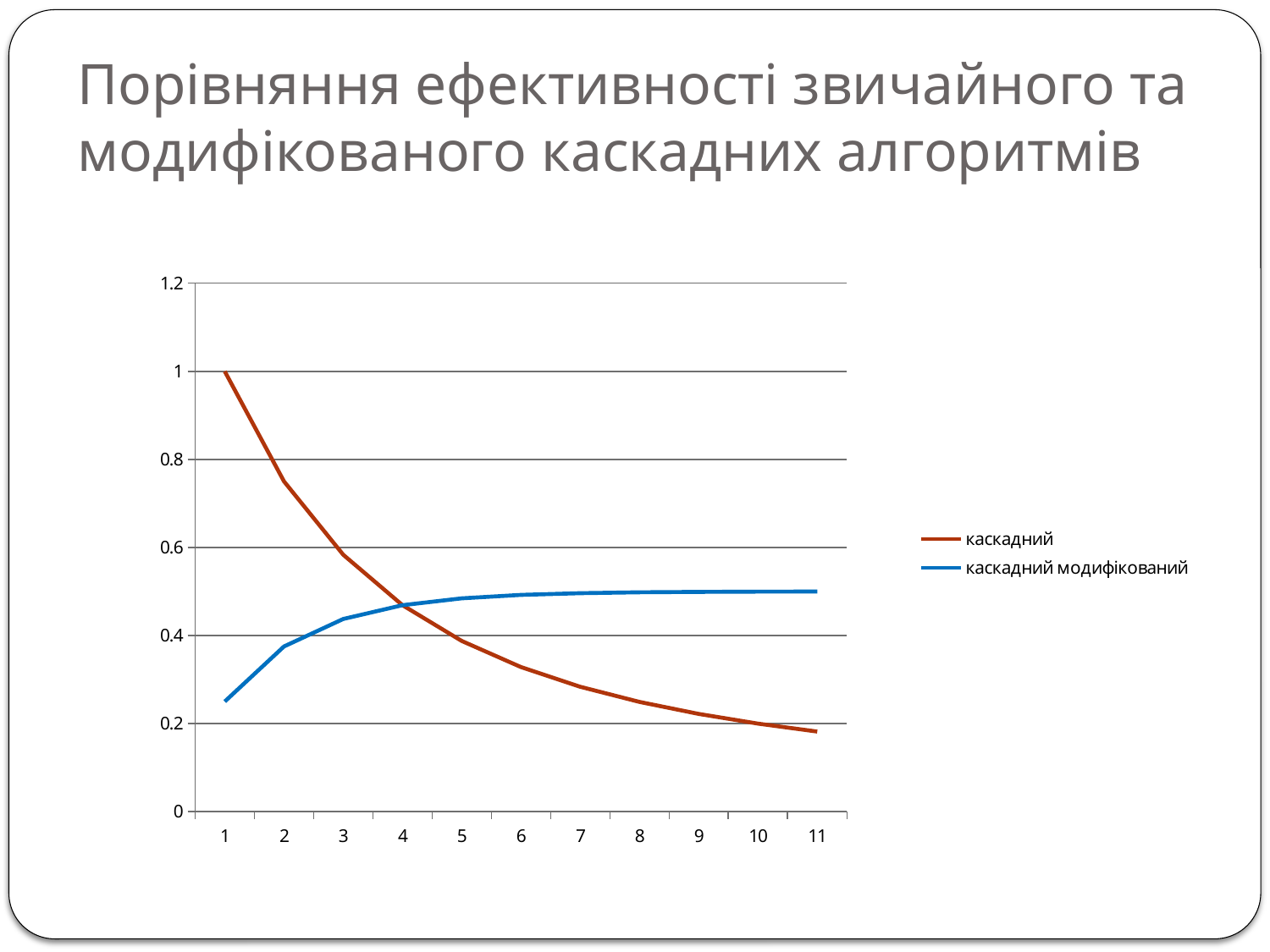
Is the value of the "каскадний модифікований" series at x = 11 greater or less than 0.4? greater At which x value is the "каскадний" series highest? 1 Does the "каскадний модифікований" series rise or fall as x increases from 1 to 11? rise At x = 11, which series has the larger value, "каскадний" or "каскадний модифікований"? каскадний модифікований What is the value of the "каскадний" series at x = 1? 1 How many points are plotted along the x axis for each series? 11 How many series does the legend list? 2 What kind of chart is shown on the slide? line chart Does the "каскадний" series rise or fall as x increases from 1 to 11? fall Is the value of the "каскадний" series at x = 2 greater or less than 0.6? greater At x = 1, which series has the larger value, "каскадний" or "каскадний модифікований"? каскадний At which x value is the "каскадний модифікований" series lowest? 1